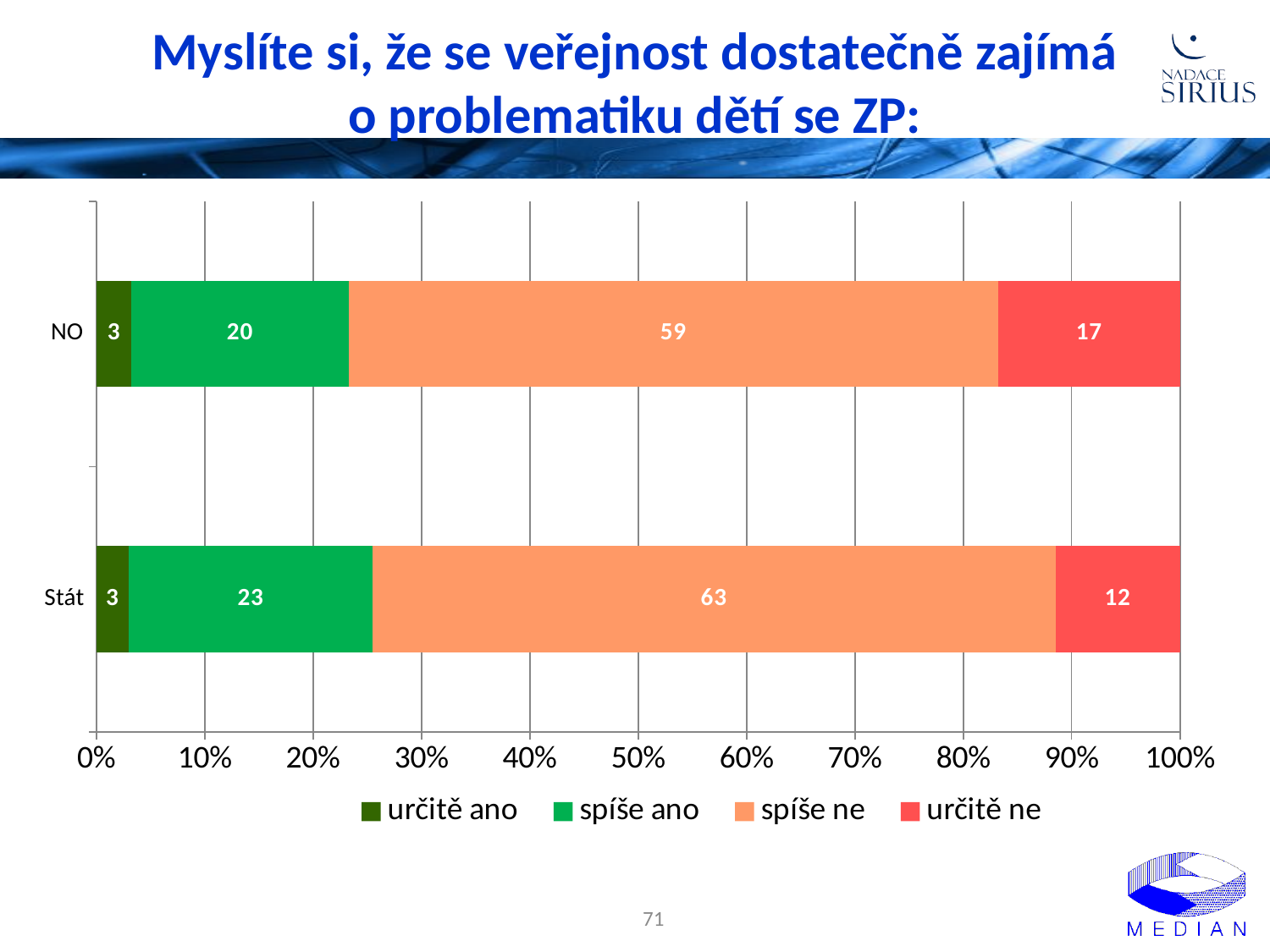
What is the value of 'spíše ano' for Stát? 23 What is the value of 'spíše ne' for NO? 59 What is the difference between the 'spíše ne' values for Stát and NO? 4 What is the difference between the 'určitě ne' values for NO and Stát? 5 What kind of chart is shown on the slide? stacked bar chart What is the value of 'určitě ano' for Stát? 3 Which series has the largest value in the Stát bar? spíše ne Which series has the smallest value in the NO bar? určitě ano How many series does the legend list? 4 What is the value of 'určitě ne' for NO? 17 How many categories are shown on the chart? 2 Which category has the higher value for 'spíše ne', NO or Stát? Stát